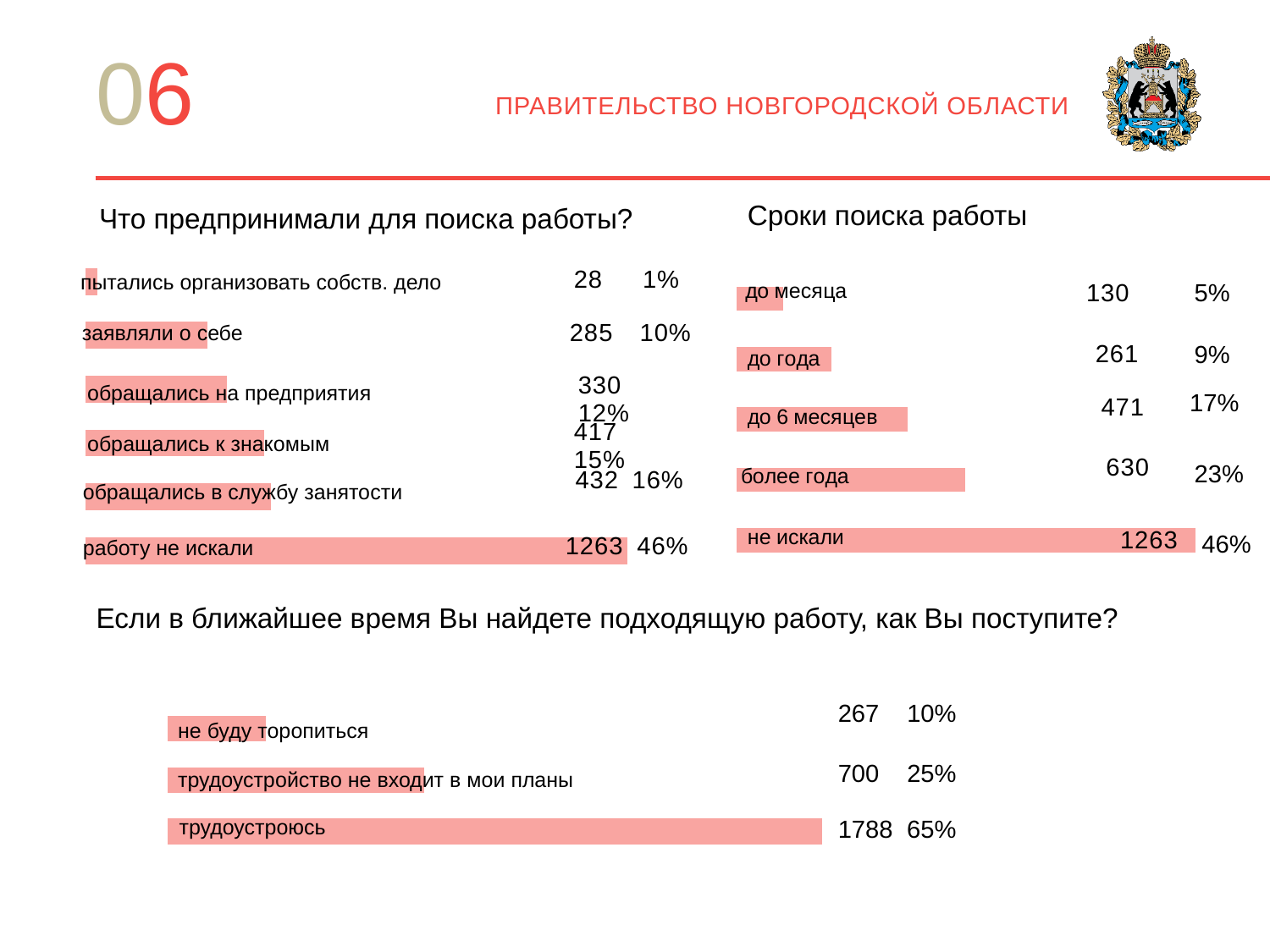
In the chart "Сроки поиска работы", which category has the highest value? не искали In the chart "Что предпринимали для поиска работы?", what percentage is shown for "заявляли о себе"? 10% In the chart "Что предпринимали для поиска работы?", what is the value for "работу не искали"? 1263 In the chart "Что предпринимали для поиска работы?", which category has the lowest value? пытались организовать собств. дело In the chart "Если в ближайшее время Вы найдете подходящую работу, как Вы поступите?", what percentage is shown for "трудоустройство не входит в мои планы"? 25% In the chart "Сроки поиска работы", which is larger: "до года" or "до 6 месяцев"? до 6 месяцев In the chart "Сроки поиска работы", what percentage is shown for "до 6 месяцев"? 17% In the chart "Если в ближайшее время Вы найдете подходящую работу, как Вы поступите?", what is the value for "трудоустроюсь"? 1788 In the chart "Сроки поиска работы", what is the difference between the values for "более года" and "до месяца"? 500 What type of chart is used for "Если в ближайшее время Вы найдете подходящую работу, как Вы поступите?"? bar chart In the chart "Сроки поиска работы", what is the value for "более года"? 630 In the chart "Что предпринимали для поиска работы?", how many categories are shown? 6